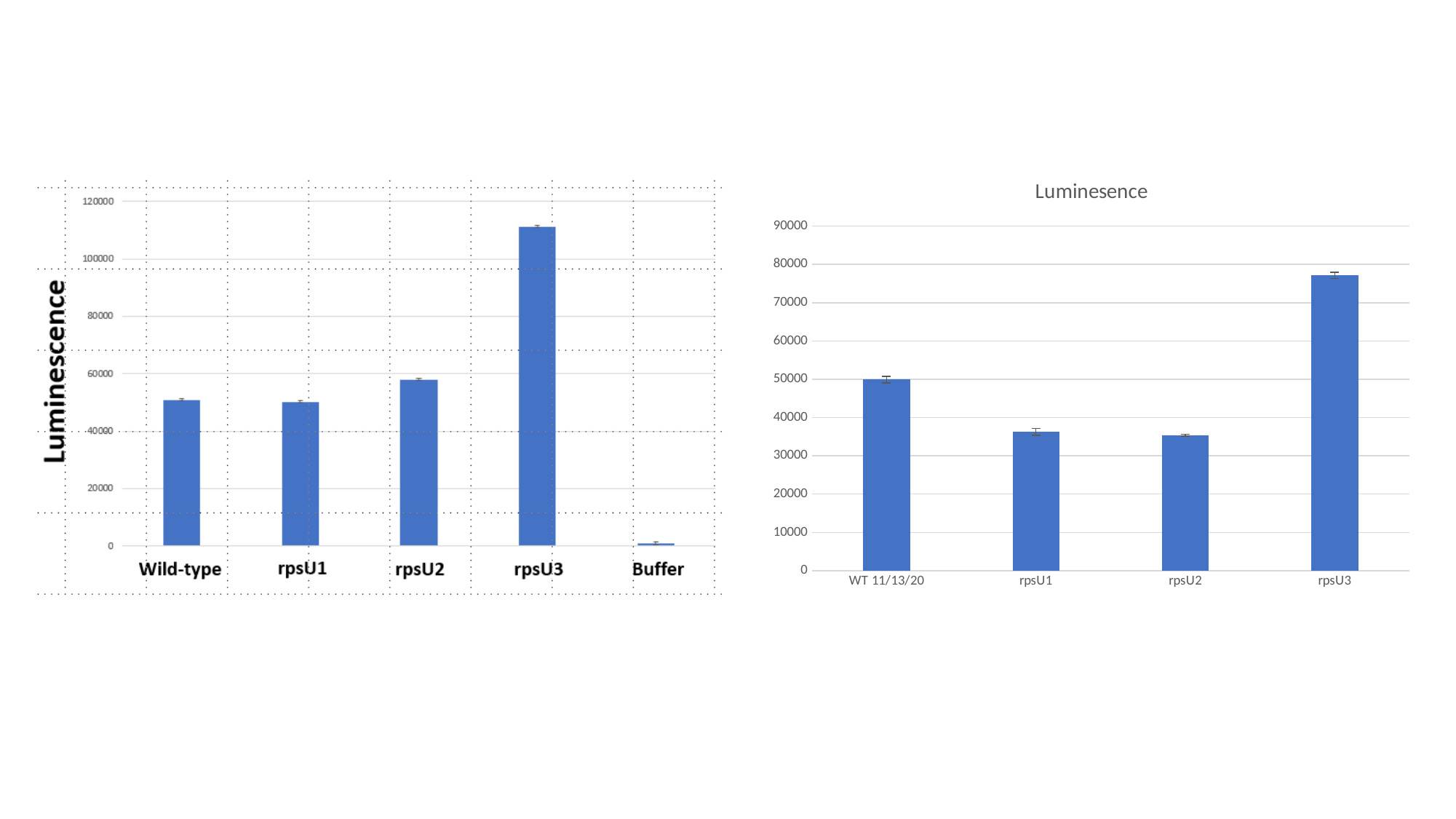
How many categories does the right chart titled 'Luminesence' show? 4 In the left chart, which is larger, the value for rpsU2 or the value for rpsU1? rpsU2 In the left chart, which category has the highest luminescence? rpsU3 What is the title of the right chart? Luminesence What is the y-axis label of the left chart? Luminescence In the right chart titled 'Luminesence', is the value for WT 11/13/20 greater or less than 40000? greater How many categories does the left chart show? 5 What kind of chart is the left chart on the slide? bar chart In the right chart titled 'Luminesence', which category has the highest value? rpsU3 In the left chart, is the value for rpsU3 greater or less than 100000? greater In the left chart, is the value for rpsU2 greater or less than 60000? less In the left chart, which category has the lowest luminescence? Buffer